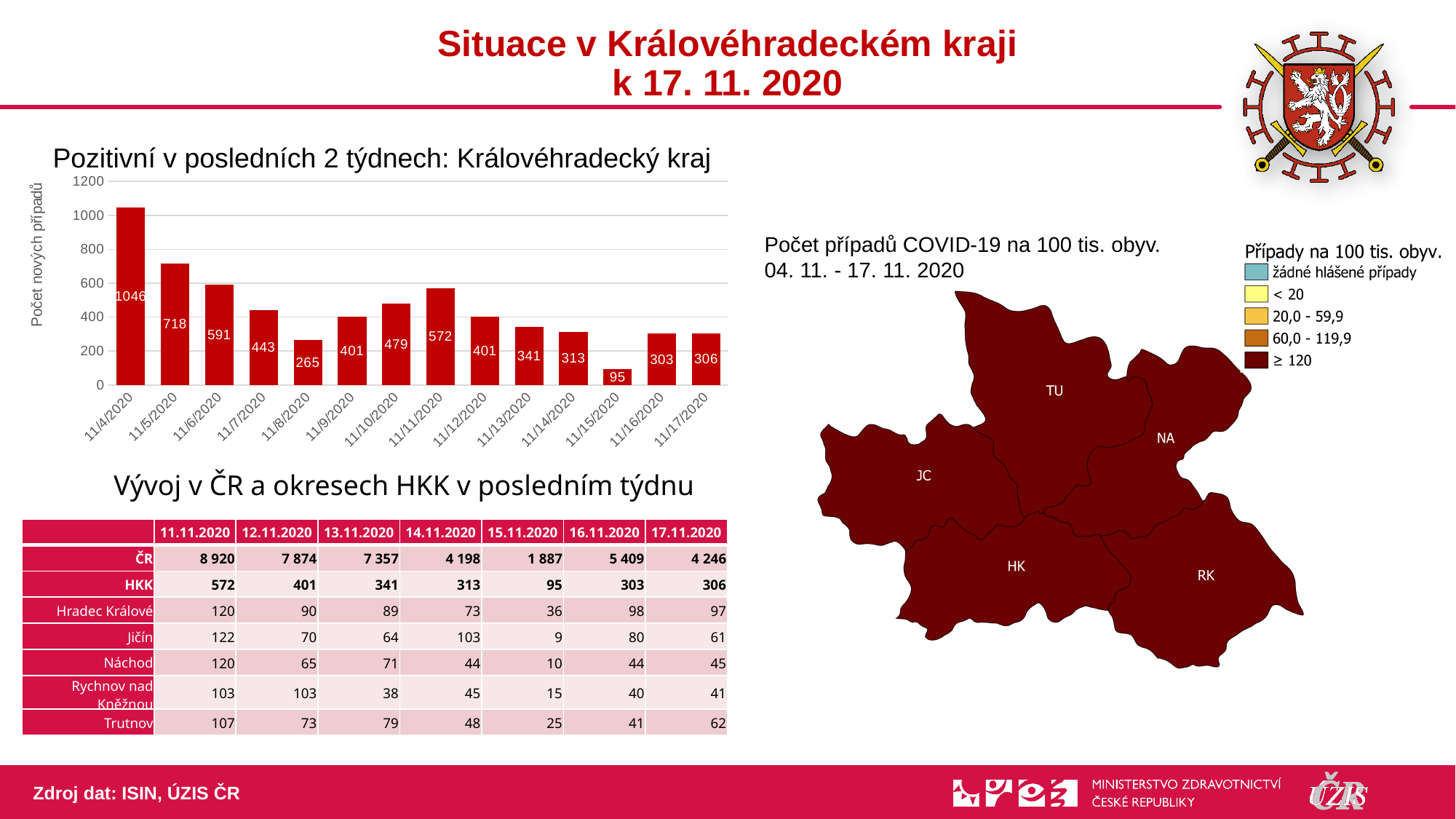
Which is larger in the bar chart: the value for 11/7/2020 or the value for 11/8/2020? 11/7/2020 What is the title of the bar chart? Pozitivní v posledních 2 týdnech: Královéhradecký kraj How many dates are shown on the x axis of the bar chart? 14 What is the value for 11/15/2020 in the bar chart? 95 What is the value for 11/10/2020 in the bar chart? 479 Is the value for 11/11/2020 in the bar chart greater or less than 400? greater Which date has the highest value in the bar chart? 11/4/2020 Do the values in the bar chart rise or fall from 11/4/2020 to 11/8/2020? fall What type of chart is shown on the slide? bar chart What is the difference between the values for 11/5/2020 and 11/6/2020 in the bar chart? 127 Which date has the lowest value in the bar chart? 11/15/2020 What is the value for 11/4/2020 in the bar chart? 1046